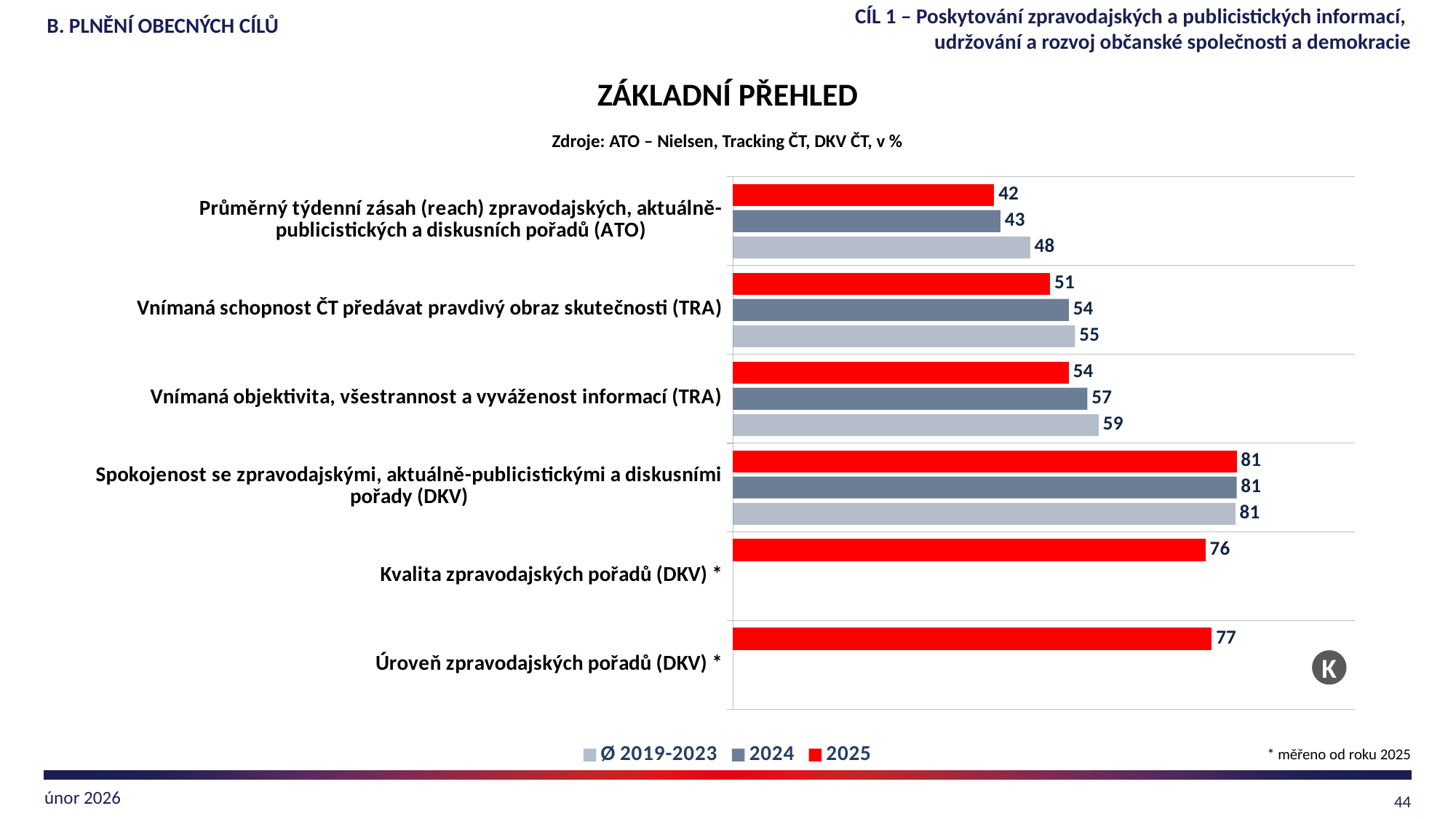
What kind of chart is shown on the slide? Bar chart What is the 2024 value for 'Vnímaná schopnost ČT předávat pravdivý obraz skutečnosti (TRA)'? 54 What is the Ø 2019-2023 value for 'Vnímaná objektivita, všestrannost a vyváženost informací (TRA)'? 59 How many series does the legend list? 3 What is the difference between the Ø 2019-2023 value and the 2025 value for 'Průměrný týdenní zásah (reach) zpravodajských, aktuálně-publicistických a diskusních pořadů (ATO)'? 6 Which is larger for 'Vnímaná objektivita, všestrannost a vyváženost informací (TRA)': the 2024 value or the 2025 value? 2024 Which category has the lowest 2025 value? Průměrný týdenní zásah (reach) zpravodajských, aktuálně-publicistických a diskusních pořadů (ATO) What is the 2025 value for 'Průměrný týdenní zásah (reach) zpravodajských, aktuálně-publicistických a diskusních pořadů (ATO)'? 42 What is the 2025 value for 'Kvalita zpravodajských pořadů (DKV)'? 76 Which colour represents the 2025 series in the chart? Red How many categories are shown on the chart? 6 Which category has the highest 2025 value? Spokojenost se zpravodajskými, aktuálně-publicistickými a diskusními pořady (DKV)